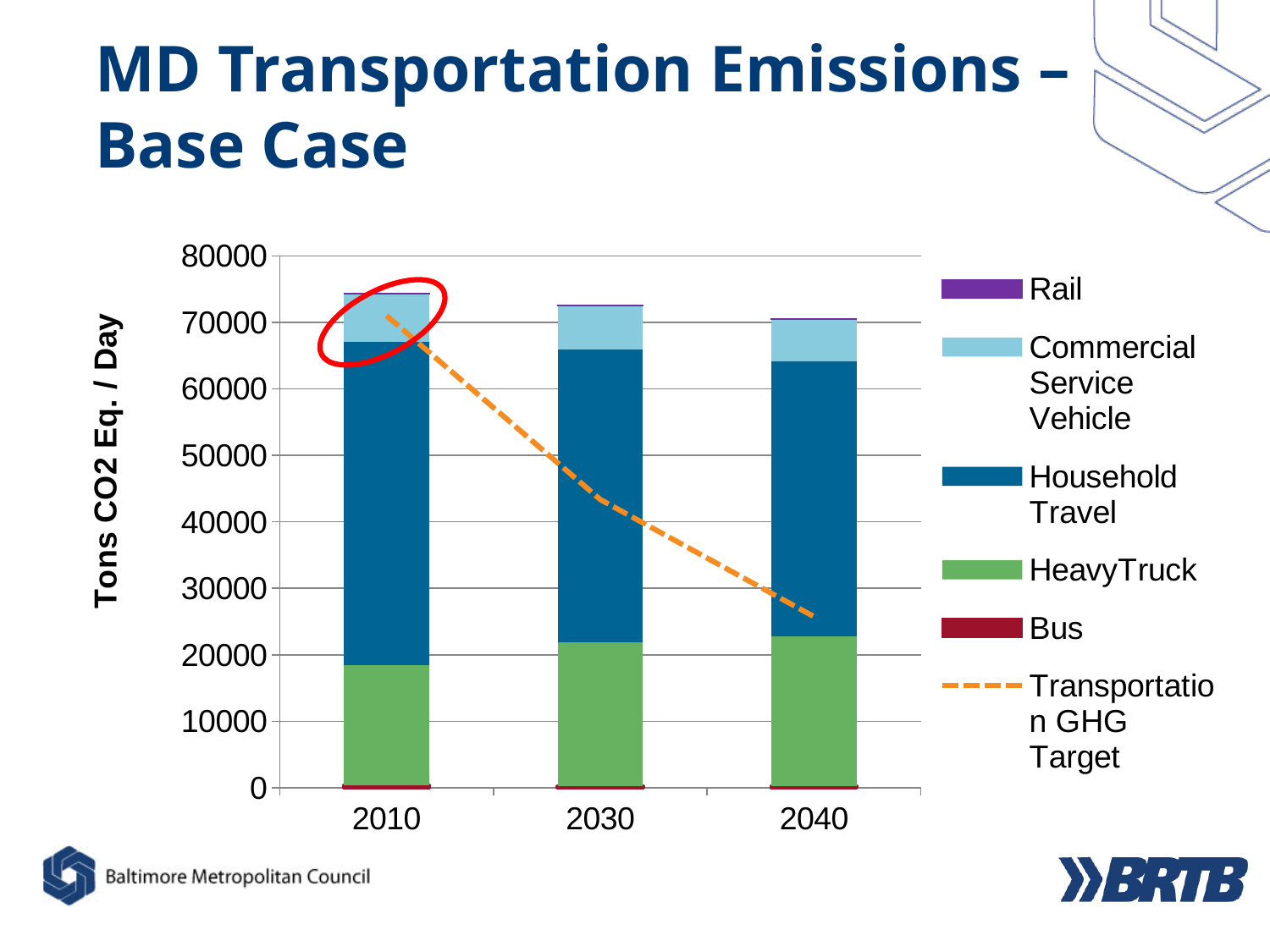
Is the HeavyTruck segment for 2030 greater or less than 20000? greater What is the title of the y axis? Tons CO2 Eq. / Day Which legend entry is drawn as an orange dashed line? Transportation GHG Target Is the Transportation GHG Target value at 2040 greater or less than 30000? less Is the total stacked bar for 2010 greater or less than 70000? greater Does the Transportation GHG Target line rise or fall from 2010 to 2040? Fall Which year has the taller total stacked bar, 2010 or 2040? 2010 How many entries does the chart's legend list? 6 Which year has the larger HeavyTruck segment, 2010 or 2040? 2040 What kind of chart is shown on the slide? Stacked bar chart with a dashed line How many years are shown on the x axis of the chart? 3